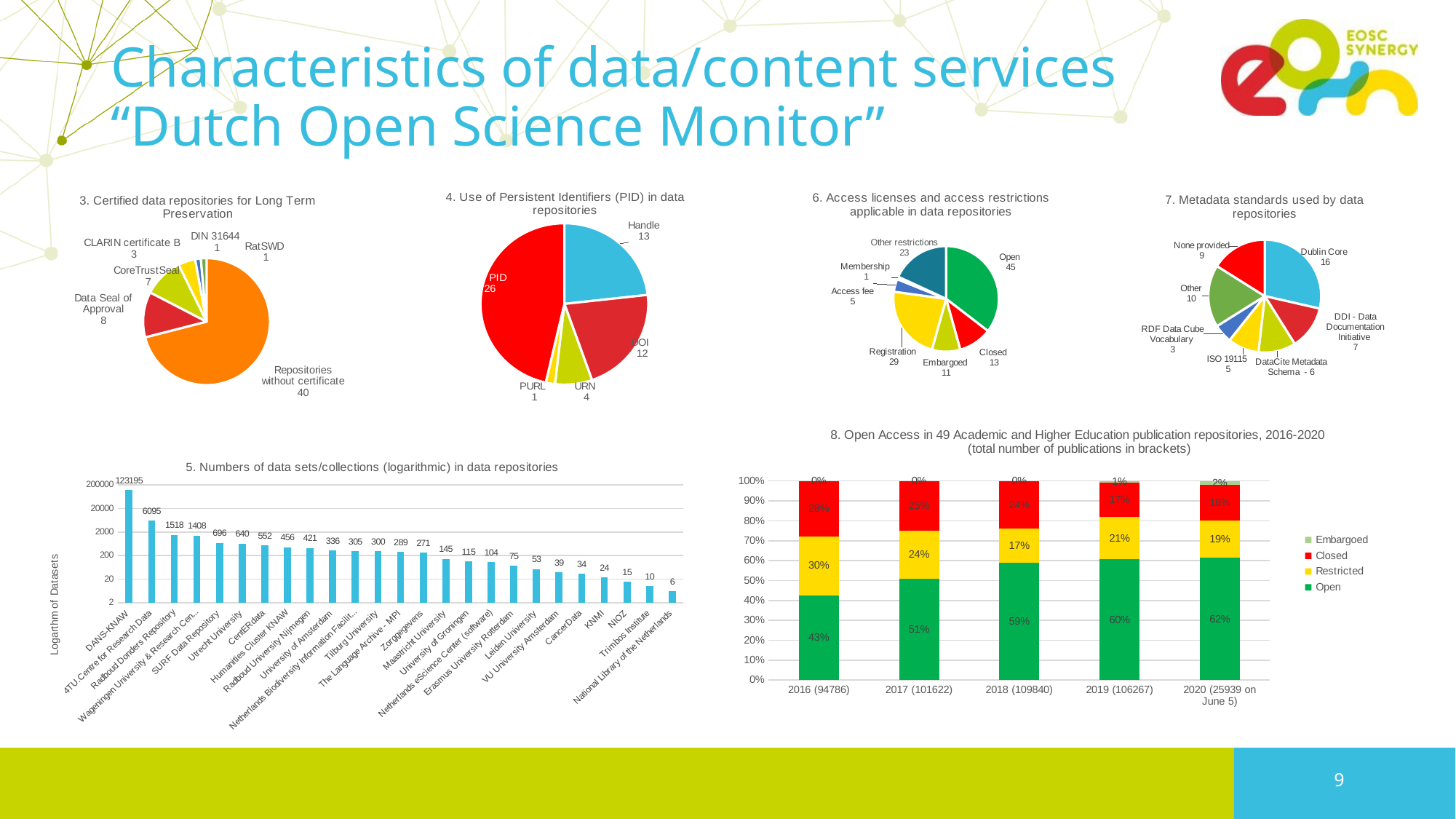
In the chart "4. Use of Persistent Identifiers (PID) in data repositories", which category has the largest slice? PID In the chart "5. Numbers of data sets/collections (logarithmic) in data repositories", what is the value for DANS-KNAW? 123195 How many repositories are shown in the chart "5. Numbers of data sets/collections (logarithmic) in data repositories"? 25 In the chart "4. Use of Persistent Identifiers (PID) in data repositories", what is the difference between the Handle and DOI values? 1 In the chart "7. Metadata standards used by data repositories", which is larger: Other or None provided? Other What kind of chart is "5. Numbers of data sets/collections (logarithmic) in data repositories"? Bar chart In the chart "8. Open Access in 49 Academic and Higher Education publication repositories, 2016-2020", what is the Open share for 2018 (109840)? 59% In the chart "3. Certified data repositories for Long Term Preservation", how many repositories are without certificate? 40 In the chart "6. Access licenses and access restrictions applicable in data repositories", what is the value for Registration? 29 How many series does the legend list in the chart "8. Open Access in 49 Academic and Higher Education publication repositories, 2016-2020"? 4 In the chart "6. Access licenses and access restrictions applicable in data repositories", which category has the smallest value? Membership In the chart "7. Metadata standards used by data repositories", what is the value for Dublin Core? 16